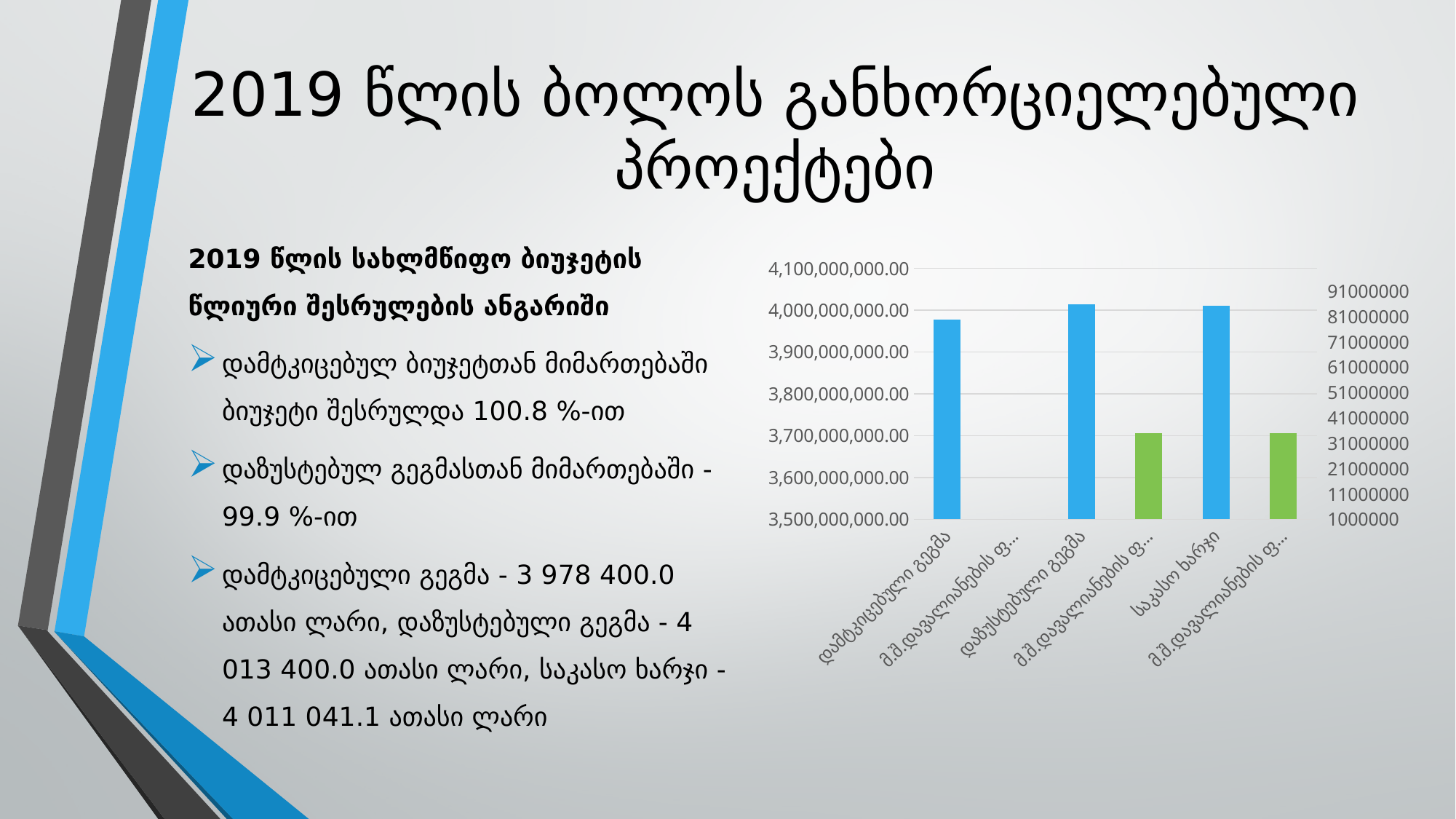
Which is larger, the bar for დამტკიცებული გეგმა or the bar for დაზუსტებული გეგმა? დაზუსტებული გეგმა Is the value for დამტკიცებული გეგმა greater or less than 3,900,000,000.00 on the left axis? greater How many green bars are there in the chart? 2 Is the value for საკასო ხარჯი greater or less than 3,900,000,000.00 on the left axis? greater What kind of chart is shown on the slide? bar chart What is the lowest tick label on the right vertical axis of the chart? 1000000 How many categories (bars) are plotted in the chart? 6 How many blue bars are there in the chart? 3 What is the lowest tick label on the left vertical axis of the chart? 3,500,000,000.00 Which of the three blue bars is the shortest? დამტკიცებული გეგმა What is the highest tick label on the left vertical axis of the chart? 4,100,000,000.00 Is the value for დაზუსტებული გეგმა greater or less than 4,000,000,000.00 on the left axis? greater